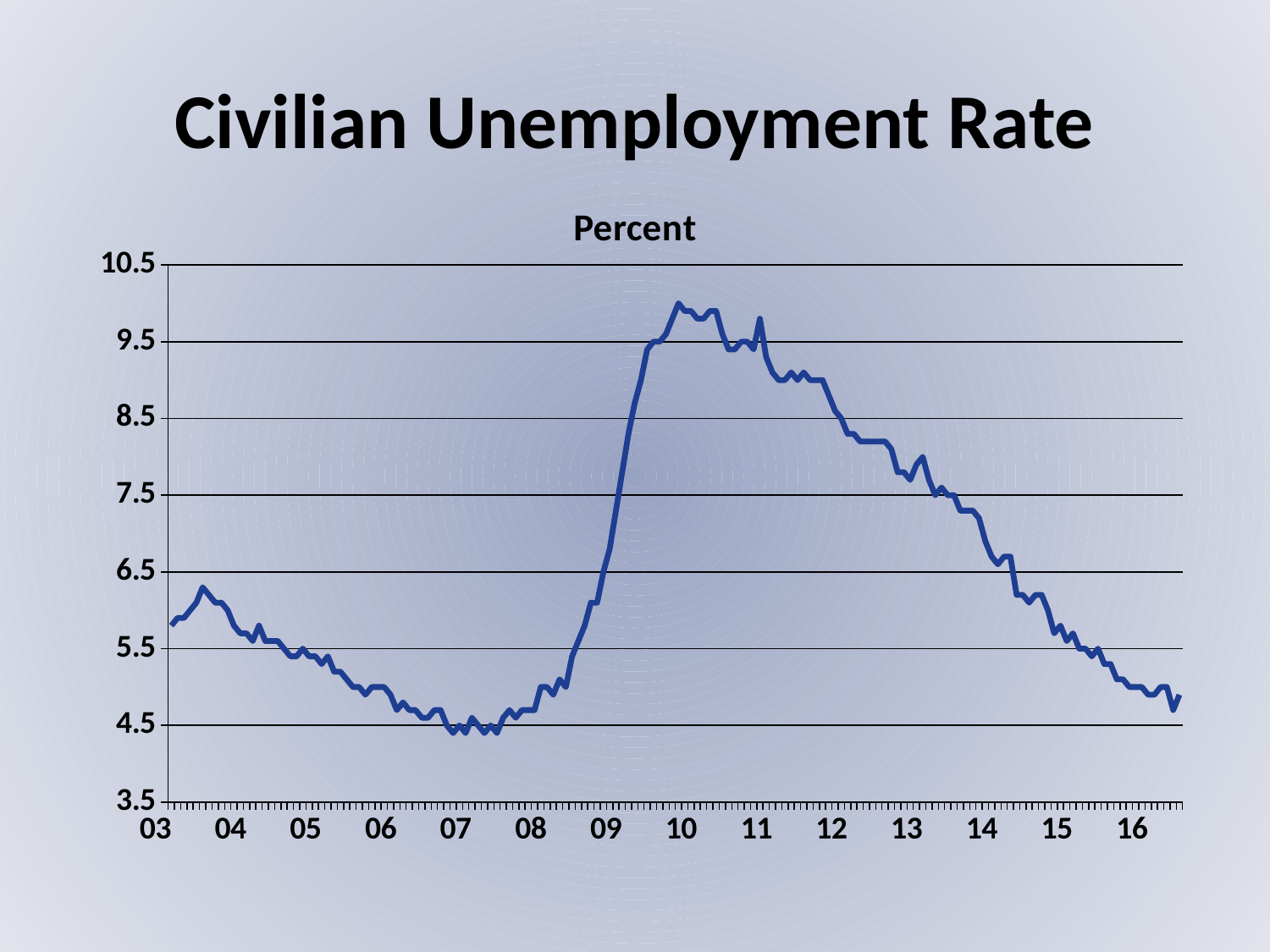
Which is larger, the value at the 10 label or the value at the 16 label? 10 How many year labels are shown on the x axis? 14 Is the value at the 13 label greater or less than 7.5? greater What kind of chart is shown on the slide? line chart What unit label is shown above the chart's plot area? Percent Is the value at the 03 label greater or less than 5.5? greater Does the line rise or fall between the 10 label and the 16 label? fall What is the title of the chart? Civilian Unemployment Rate Does the line rise or fall between the 07 label and the 10 label? rise Is the value at the 16 label greater or less than 5.5? less